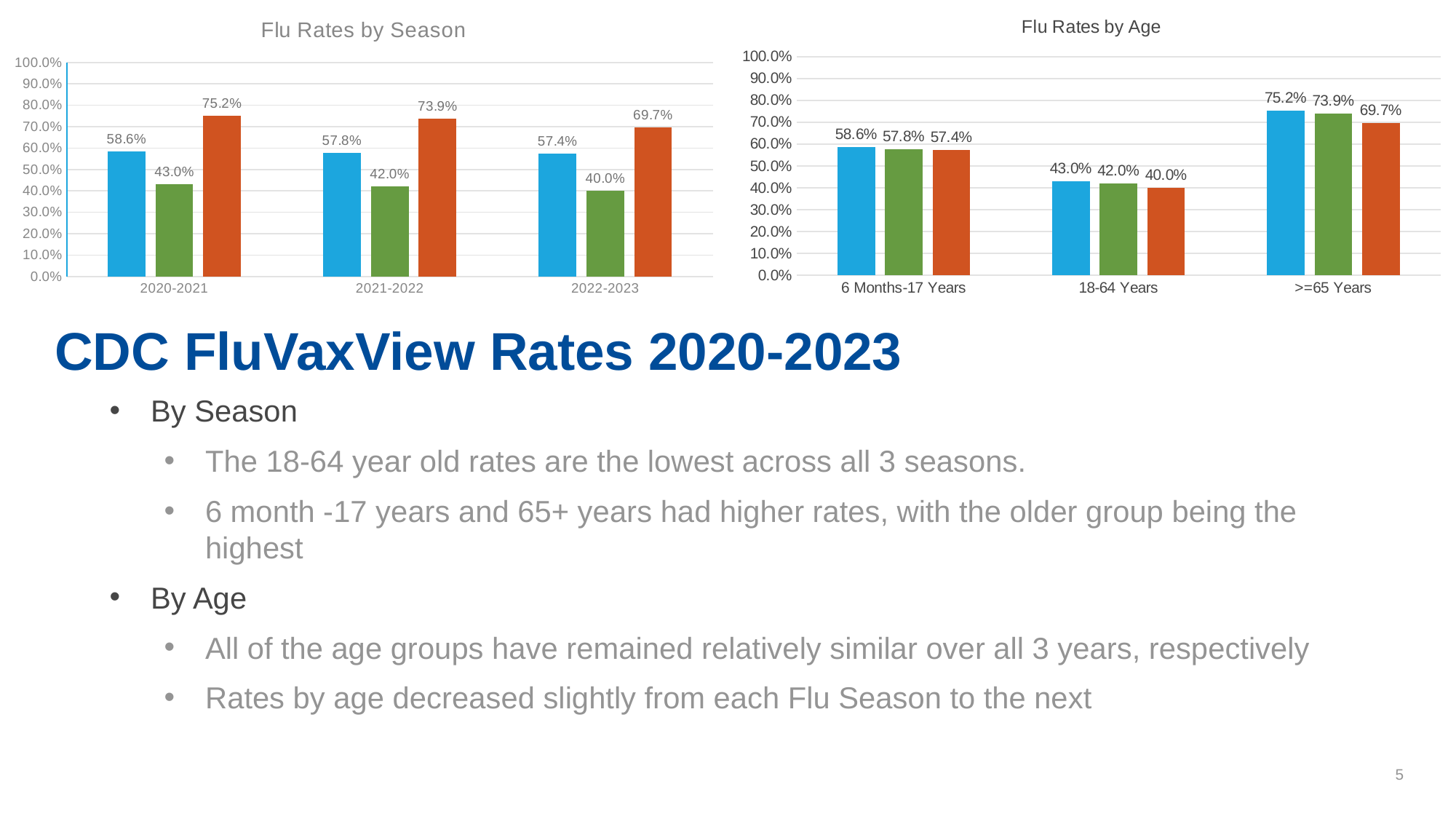
In the 'Flu Rates by Age' chart, which age group has the highest rates? >=65 Years What kind of chart is the 'Flu Rates by Season' chart on the left? bar chart What is the title of the chart on the right side of the slide? Flu Rates by Age In the 'Flu Rates by Age' chart, what is the value of the blue bar for 18-64 Years? 43.0% In the 'Flu Rates by Season' chart, do the orange bars rise or fall from 2020-2021 to 2022-2023? fall In the 'Flu Rates by Season' chart, what is the value of the tallest bar for 2020-2021? 75.2% In the 'Flu Rates by Age' chart, is the green bar for >=65 Years greater or less than 70.0%? greater In the 'Flu Rates by Season' chart, what is the value of the lowest bar for 2022-2023? 40.0% In the 'Flu Rates by Season' chart, how many seasons are shown on the x axis? 3 In the 'Flu Rates by Age' chart, which age group has the lowest rates? 18-64 Years In the 'Flu Rates by Age' chart, what is the difference between the blue bar and the orange bar for 6 Months-17 Years? 1.2% In the 'Flu Rates by Season' chart, what is the difference between the highest and lowest bars for 2021-2022? 31.9%